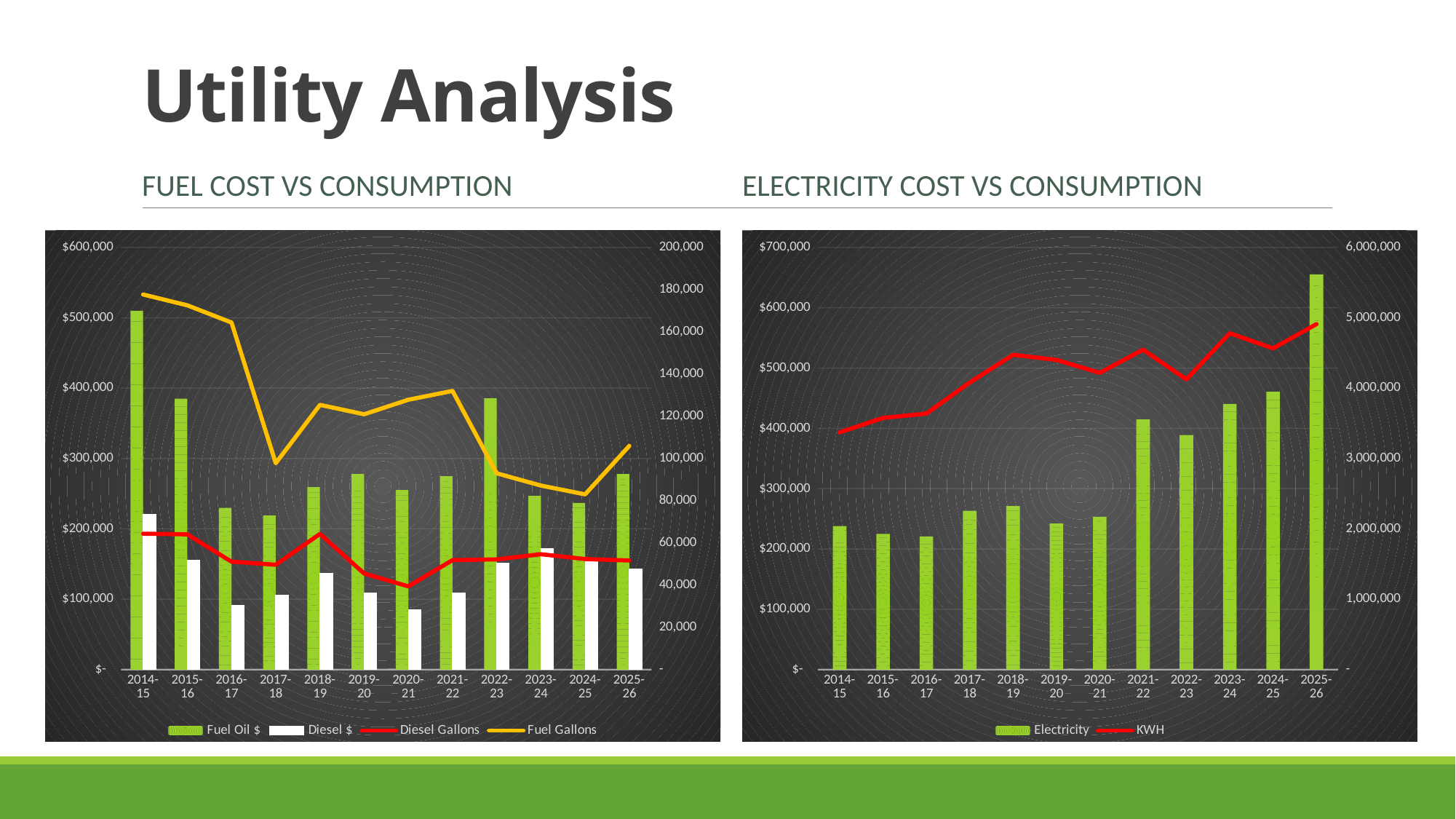
On the Fuel Cost vs Consumption chart, which is larger, the Fuel Oil $ bar for 2022-23 or for 2023-24? 2022-23 On the Fuel Cost vs Consumption chart, is the Fuel Gallons value for 2014-15 greater or less than 160,000? greater On the Electricity Cost vs Consumption chart, which year has the highest Electricity bar? 2025-26 On the Electricity Cost vs Consumption chart, is the KWH value for 2014-15 greater or less than 4,000,000? less On the Fuel Cost vs Consumption chart, which year has the lowest Fuel Gallons value? 2024-25 On the Fuel Cost vs Consumption chart, is the Fuel Oil $ value for 2014-15 greater or less than $400,000? greater On the Electricity Cost vs Consumption chart, does the KWH line generally rise or fall from 2014-15 to 2025-26? rise How many series does the legend of the Fuel Cost vs Consumption chart list? 4 How many years are shown on the x axis of the Electricity Cost vs Consumption chart? 12 On the Fuel Cost vs Consumption chart, which year has the highest Fuel Oil $ bar? 2014-15 On the Electricity Cost vs Consumption chart, what colour is the KWH line? red